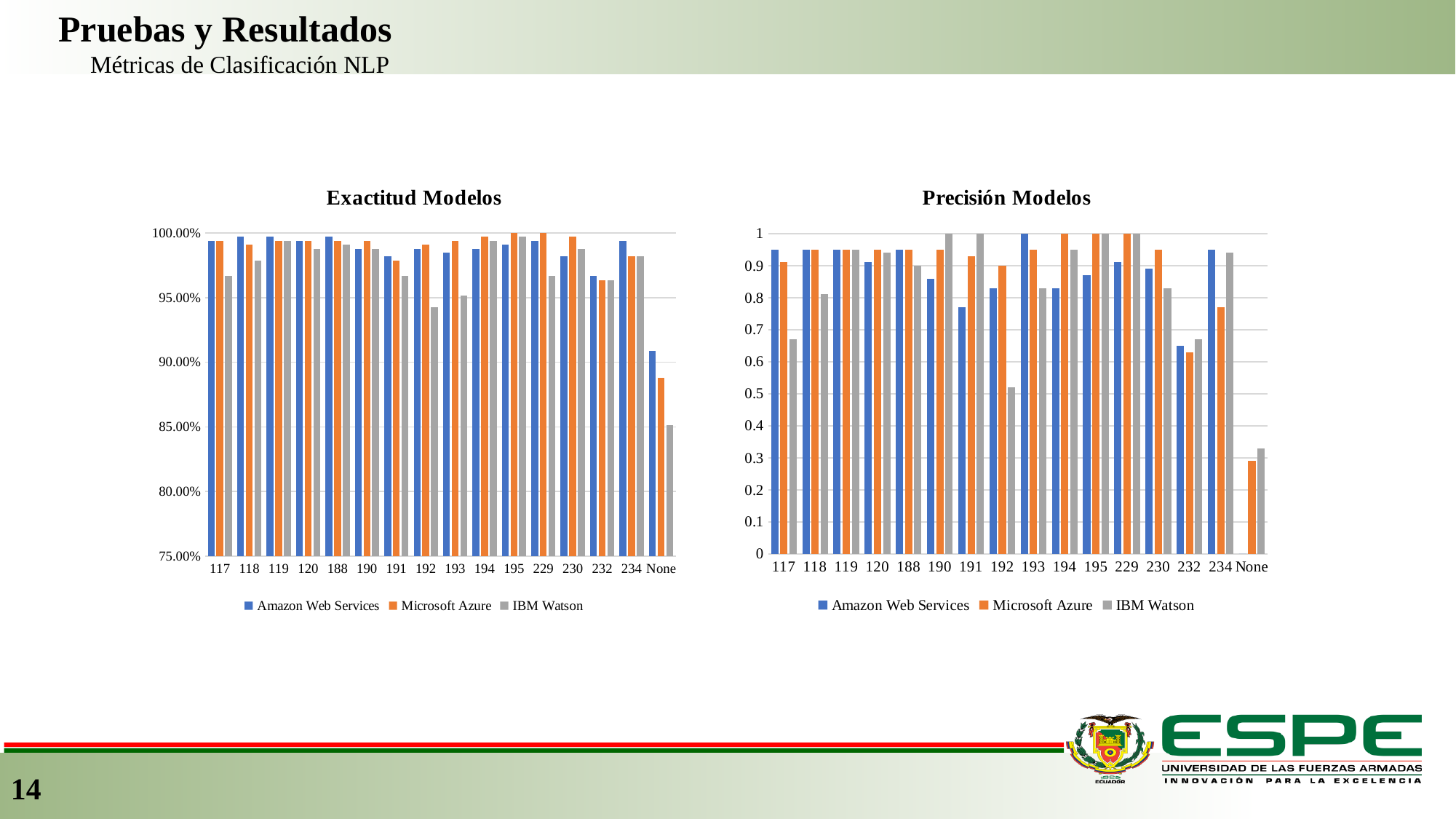
In the "Exactitud Modelos" chart, is the Microsoft Azure value for None greater or less than 90.00%? less What kind of chart is the "Exactitud Modelos" chart? bar chart How many categories are shown on the x axis of the "Exactitud Modelos" chart? 16 In the "Exactitud Modelos" chart, which is larger for None: Amazon Web Services or IBM Watson? Amazon Web Services How many series does the legend of the "Precisión Modelos" chart list? 3 In the "Precisión Modelos" chart, which is larger for 192: Microsoft Azure or IBM Watson? Microsoft Azure In the "Exactitud Modelos" chart, which category has the lowest IBM Watson value? None In the "Precisión Modelos" chart, which category has the lowest IBM Watson value? None In the "Exactitud Modelos" chart, is the IBM Watson value for None greater or less than 90.00%? less In the "Precisión Modelos" chart, is the Amazon Web Services value for 232 greater or less than 0.7? less Which series are listed in the legend of the "Exactitud Modelos" chart? Amazon Web Services, Microsoft Azure, IBM Watson